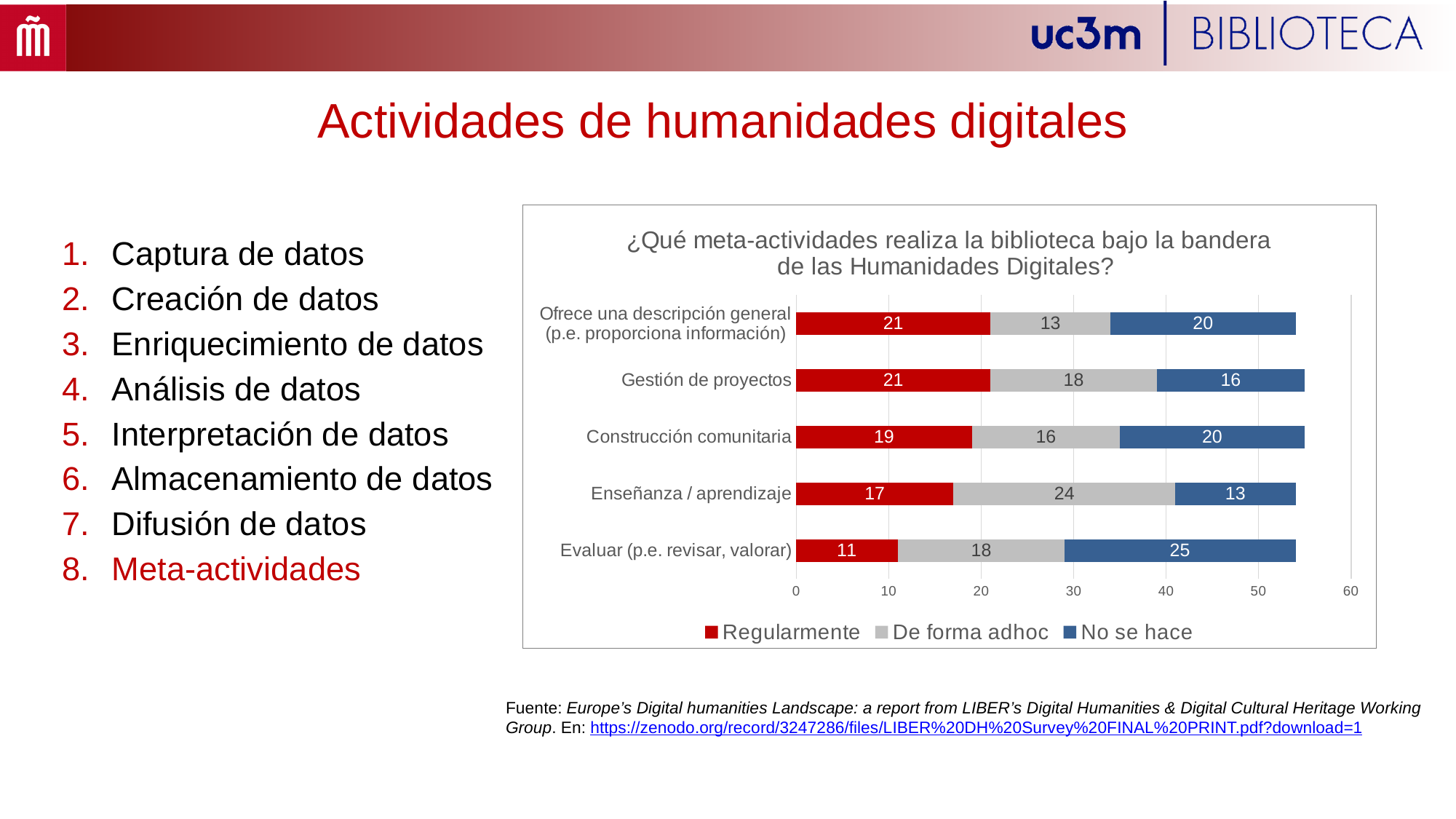
What is the total of the stacked bar for 'Gestión de proyectos'? 55 What kind of chart is shown on the slide? Stacked bar chart How many series does the chart legend list? 3 What is the 'Regularmente' value for 'Gestión de proyectos'? 21 What is the 'No se hace' value for 'Evaluar (p.e. revisar, valorar)'? 25 What is the difference between the 'No se hace' values for 'Evaluar (p.e. revisar, valorar)' and 'Enseñanza / aprendizaje'? 12 Which is larger: the 'Regularmente' value for 'Construcción comunitaria' or the 'Regularmente' value for 'Enseñanza / aprendizaje'? Construcción comunitaria Which legend entry is shown in red? Regularmente How many categories (activities) are plotted in the chart? 5 Which category has the highest 'De forma adhoc' value? Enseñanza / aprendizaje Which category has the lowest 'Regularmente' value? Evaluar (p.e. revisar, valorar) What is the 'De forma adhoc' value for 'Enseñanza / aprendizaje'? 24